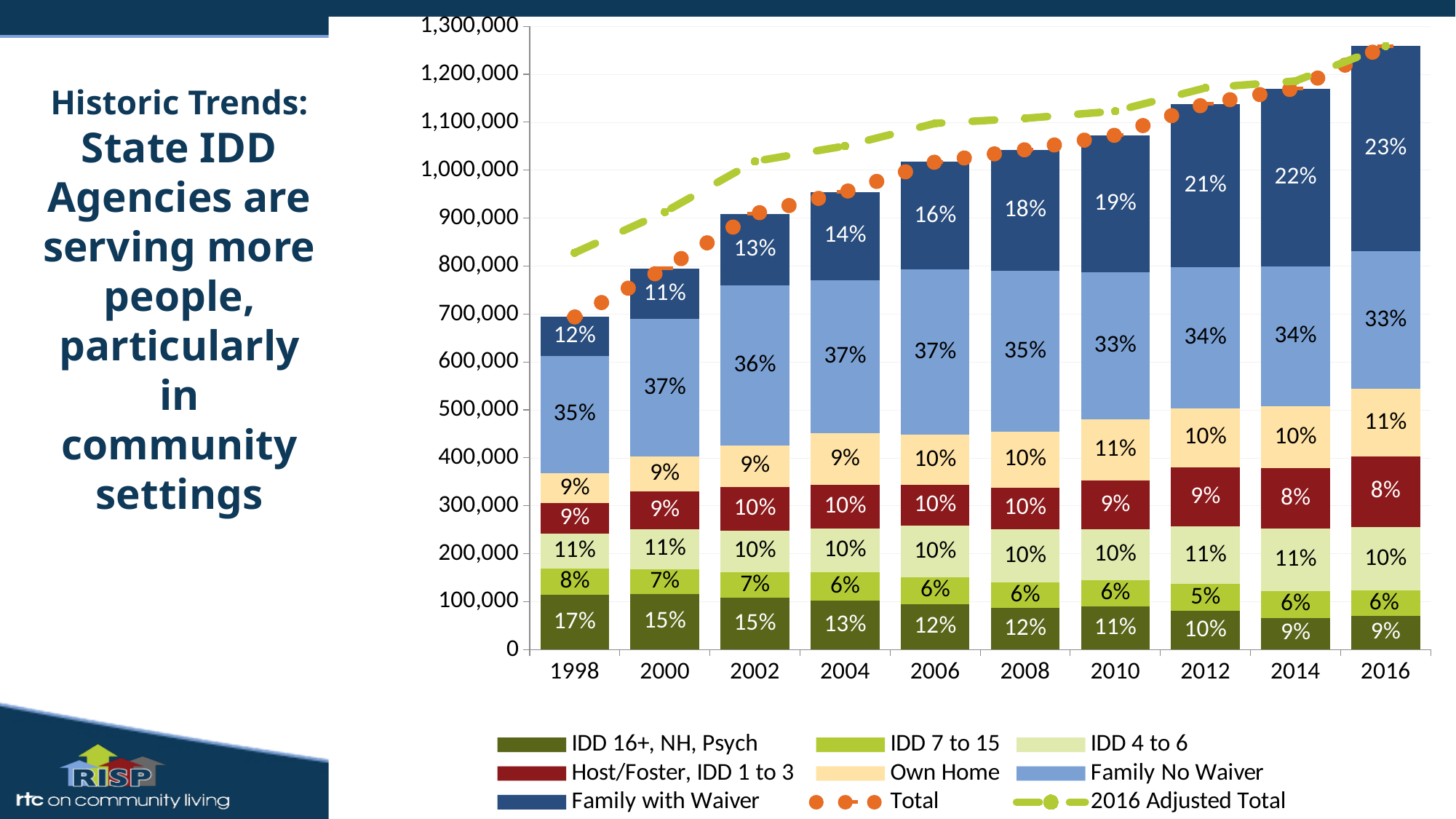
Is the total height of the 2016 stacked bar greater or less than 1,200,000? greater In which year is the Family with Waiver percentage the lowest? 2000 How many entries does the legend list? 9 How many years are shown along the x axis? 10 What percentage is shown for the IDD 16+, NH, Psych segment (bottom) in 1998? 17% Does the IDD 16+, NH, Psych percentage (bottom segment) rise or fall from 1998 to 2016? fall What percentage is shown for the Family No Waiver segment in 2000? 37% What percentage of the 2016 bar is labelled for the Family with Waiver segment (dark blue, top)? 23% In which year is the Family with Waiver percentage the highest? 2016 In 2004, which segment has the larger percentage: Family No Waiver or Own Home? Family No Waiver Is the total height of the 1998 stacked bar greater or less than 800,000? less By how many percentage points did the Family with Waiver share increase from 1998 (12%) to 2016 (23%)? 11 percentage points